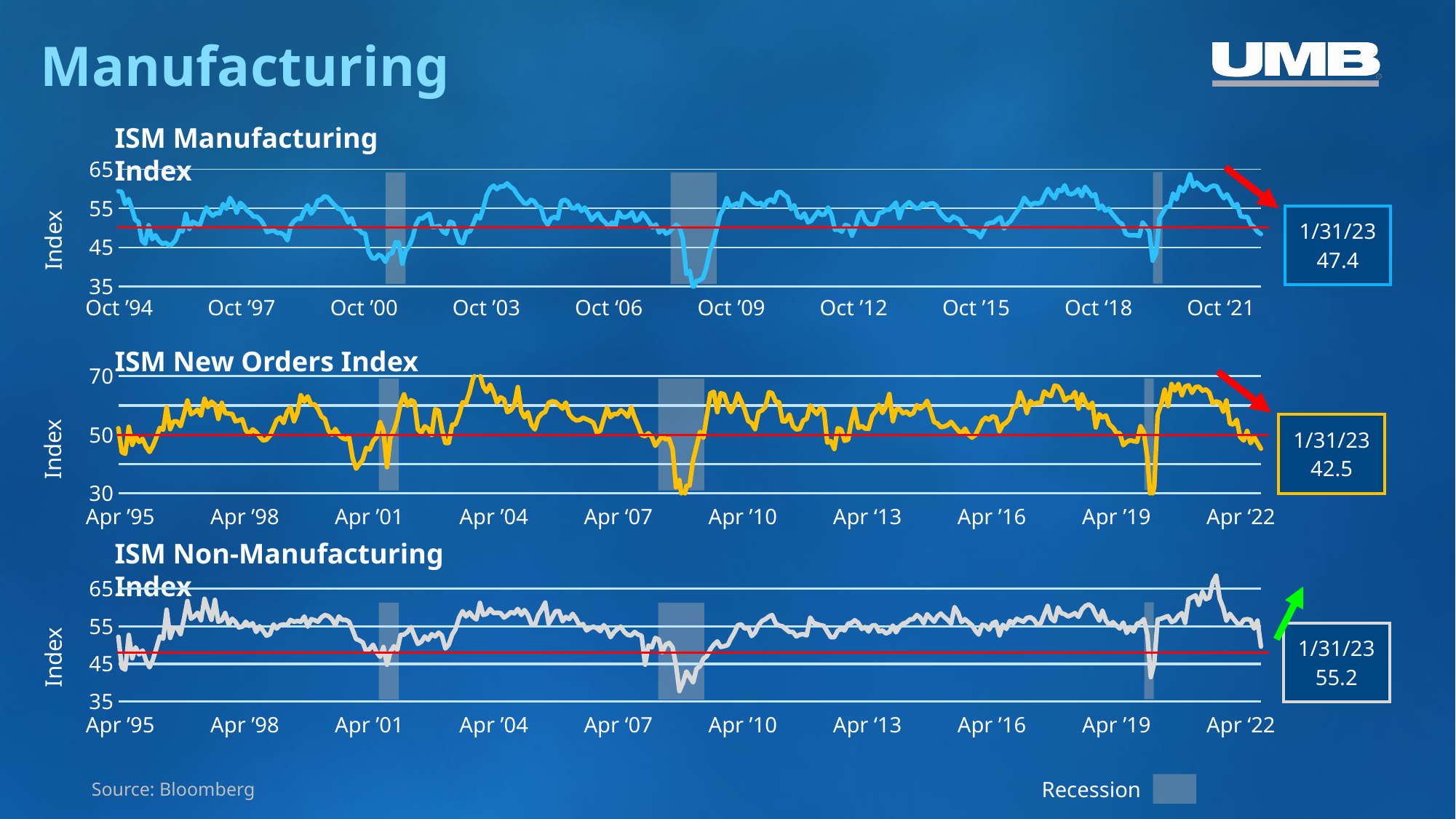
What is the difference between the 1/31/23 values of the ISM Non-Manufacturing Index and the ISM Manufacturing Index? 7.8 What do the shaded vertical bars on the charts represent? Recession What type of chart is the ISM Manufacturing Index chart? Line chart Of the three indexes on the slide, which has the lowest 1/31/23 value? ISM New Orders Index On the ISM Non-Manufacturing Index chart, what value is shown for 1/31/23? 55.2 On the ISM Manufacturing Index chart, is the value at Oct '21 greater or less than 55? greater On the ISM Manufacturing Index chart, what value is shown for 1/31/23? 47.4 Comparing the 1/31/23 values, which is higher: the ISM Manufacturing Index or the ISM Non-Manufacturing Index? ISM Non-Manufacturing Index On the ISM New Orders Index chart, what value is shown for 1/31/23? 42.5 Of the three indexes on the slide, which has the highest 1/31/23 value? ISM Non-Manufacturing Index What is the difference between the 1/31/23 values of the ISM Manufacturing Index and the ISM New Orders Index? 4.9 How many charts are shown on the slide? 3